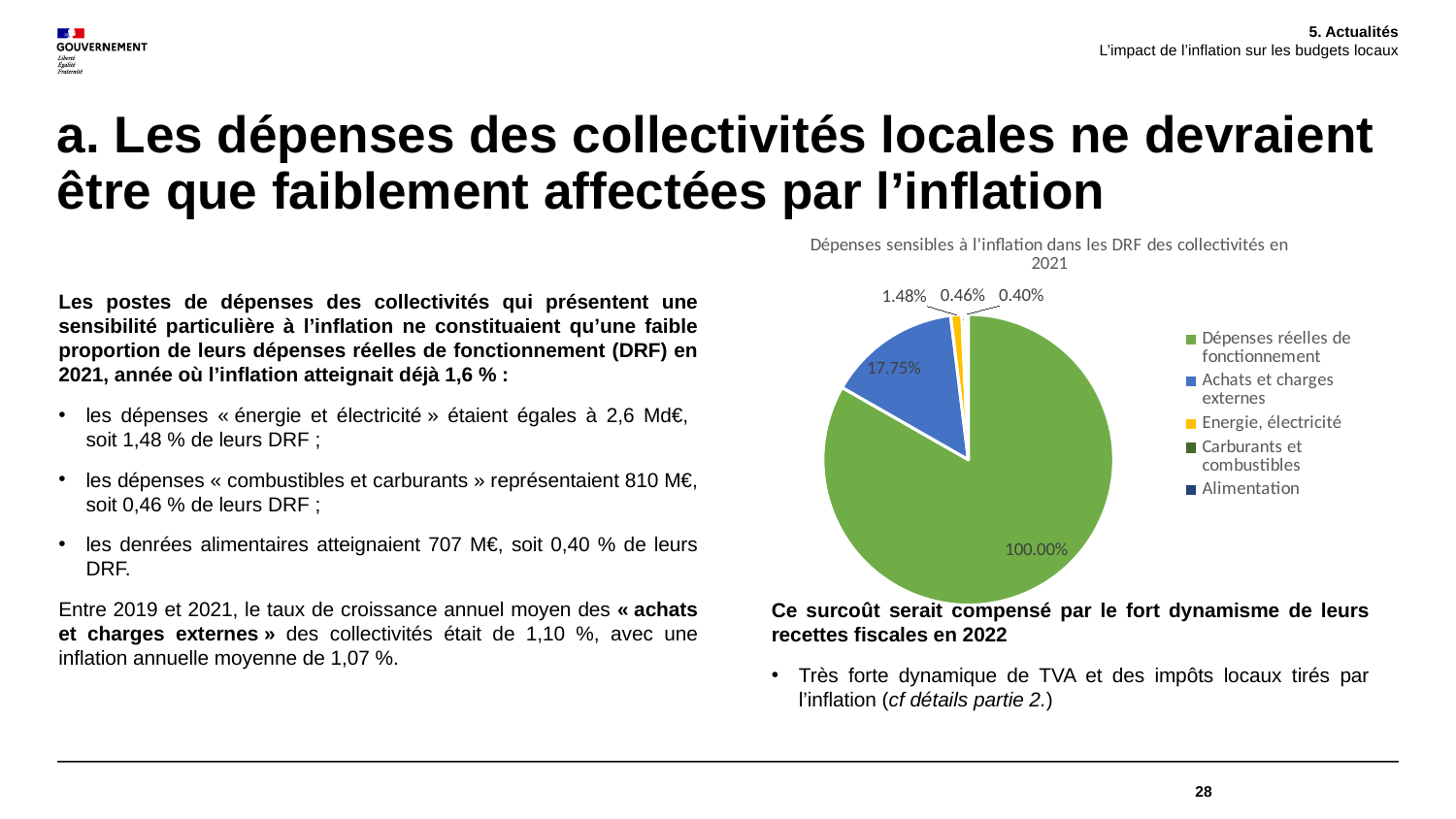
What value is labelled on the 'Achats et charges externes' slice of the pie chart? 17.75% What kind of chart is shown on the slide? pie chart What value is labelled on the 'Dépenses réelles de fonctionnement' slice of the pie chart? 100.00% What is the title of the pie chart? Dépenses sensibles à l'inflation dans les DRF des collectivités en 2021 What value is labelled for 'Alimentation' in the pie chart? 0.40% What value is labelled for 'Energie, électricité' in the pie chart? 1.48% Which legend category has the largest slice in the pie chart? Dépenses réelles de fonctionnement How many entries does the legend of the pie chart list? 5 What is the difference between the labelled values for 'Achats et charges externes' and 'Energie, électricité' in the pie chart? 16.27% In the pie chart, which is larger: the value for 'Achats et charges externes' or the value for 'Energie, électricité'? Achats et charges externes Which legend category has the smallest labelled value in the pie chart? Alimentation What value is labelled for 'Carburants et combustibles' in the pie chart? 0.46%